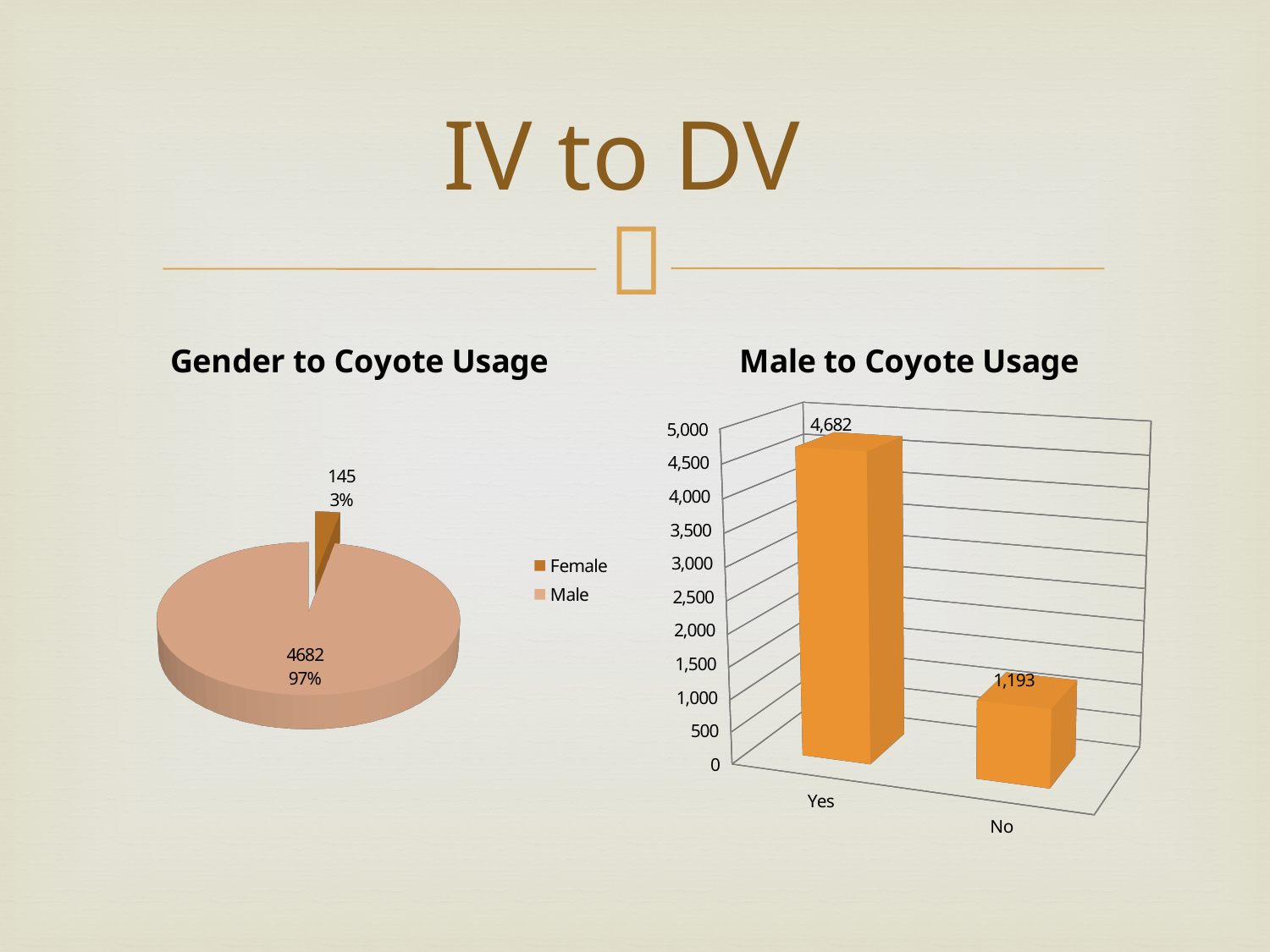
In the 'Gender to Coyote Usage' chart, what value is shown for Male? 4682 In the 'Male to Coyote Usage' chart, which category has the higher value? Yes In the 'Male to Coyote Usage' chart, what is the value for No? 1,193 In the 'Gender to Coyote Usage' chart, what percentage share does the Female slice have? 3% What kind of chart is 'Male to Coyote Usage'? Bar chart In the 'Male to Coyote Usage' chart, what is the value for Yes? 4,682 How many entries does the legend of the 'Gender to Coyote Usage' chart list? 2 In the 'Male to Coyote Usage' chart, what is the difference between the Yes and No values? 3,489 How many categories are shown on the x axis of the 'Male to Coyote Usage' chart? 2 In the 'Gender to Coyote Usage' chart, what percentage share does the Male slice have? 97% What kind of chart is 'Gender to Coyote Usage'? Pie chart In the 'Gender to Coyote Usage' chart, what value is shown for Female? 145